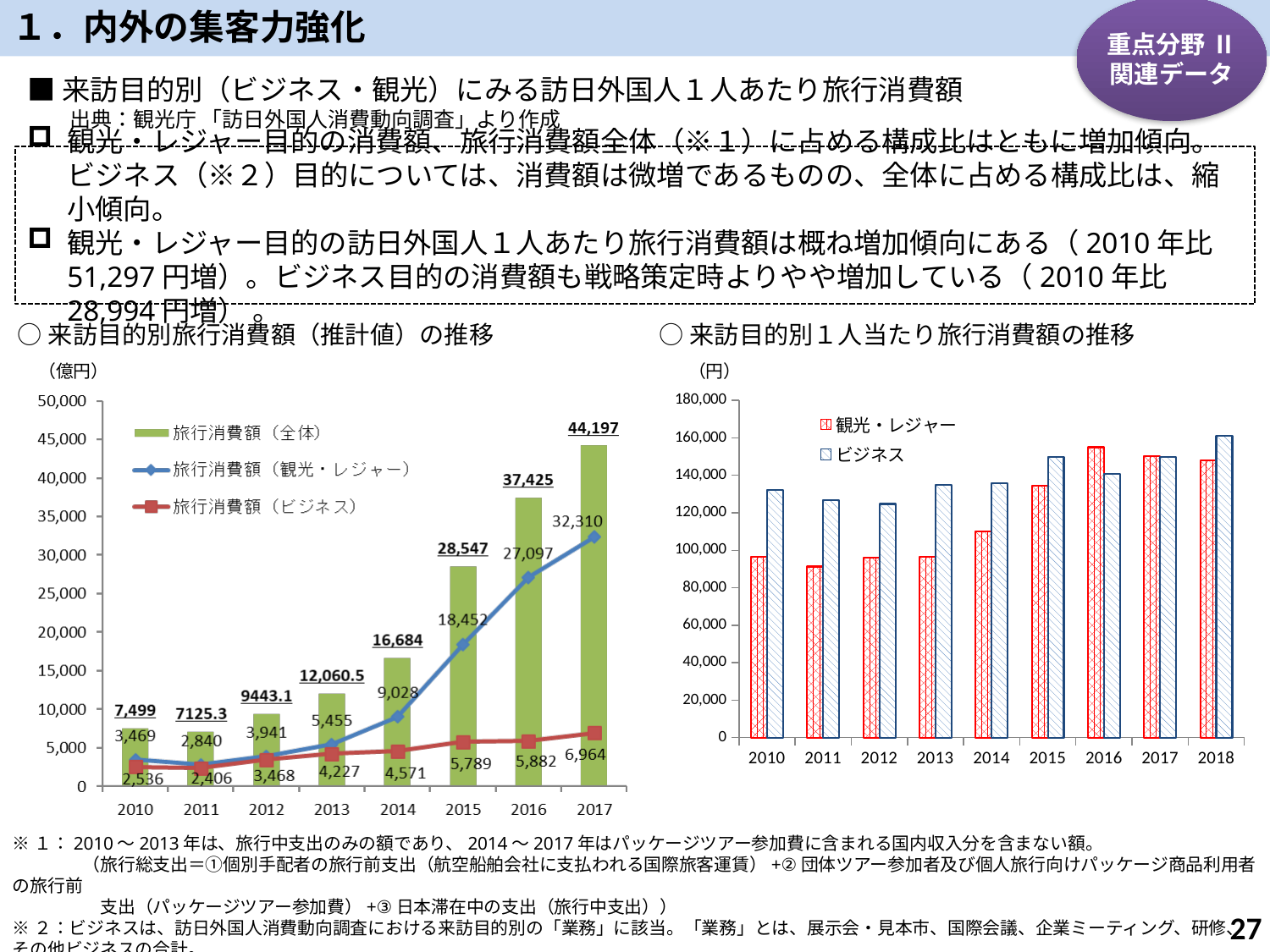
In the left chart (来訪目的別旅行消費額（推計値）の推移), what is the value of 旅行消費額（観光・レジャー） for 2015? 18,452 In the left chart (来訪目的別旅行消費額（推計値）の推移), what is the value of 旅行消費額（全体） for 2017? 44,197 In the right chart (来訪目的別1人当たり旅行消費額の推移), which is larger in 2016, 観光・レジャー or ビジネス? 観光・レジャー In the left chart (来訪目的別旅行消費額（推計値）の推移), how many years are shown on the x axis? 8 In the left chart (来訪目的別旅行消費額（推計値）の推移), which year has the lowest value for 旅行消費額（観光・レジャー）? 2011 In the left chart (来訪目的別旅行消費額（推計値）の推移), what is the value of 旅行消費額（ビジネス） for 2013? 4,227 In the left chart (来訪目的別旅行消費額（推計値）の推移), how many series does the legend list? 3 In the right chart (来訪目的別1人当たり旅行消費額の推移), is the value for 観光・レジャー in 2010 greater or less than 100,000? less In the left chart (来訪目的別旅行消費額（推計値）の推移), what is the difference between 旅行消費額（観光・レジャー） and 旅行消費額（ビジネス） in 2017? 25,346 In the right chart (来訪目的別1人当たり旅行消費額の推移), how many years are shown on the x axis? 9 In the left chart (来訪目的別旅行消費額（推計値）の推移), does 旅行消費額（全体） rise or fall from 2013 to 2017? rise What kind of chart is the right chart (来訪目的別1人当たり旅行消費額の推移)? bar chart